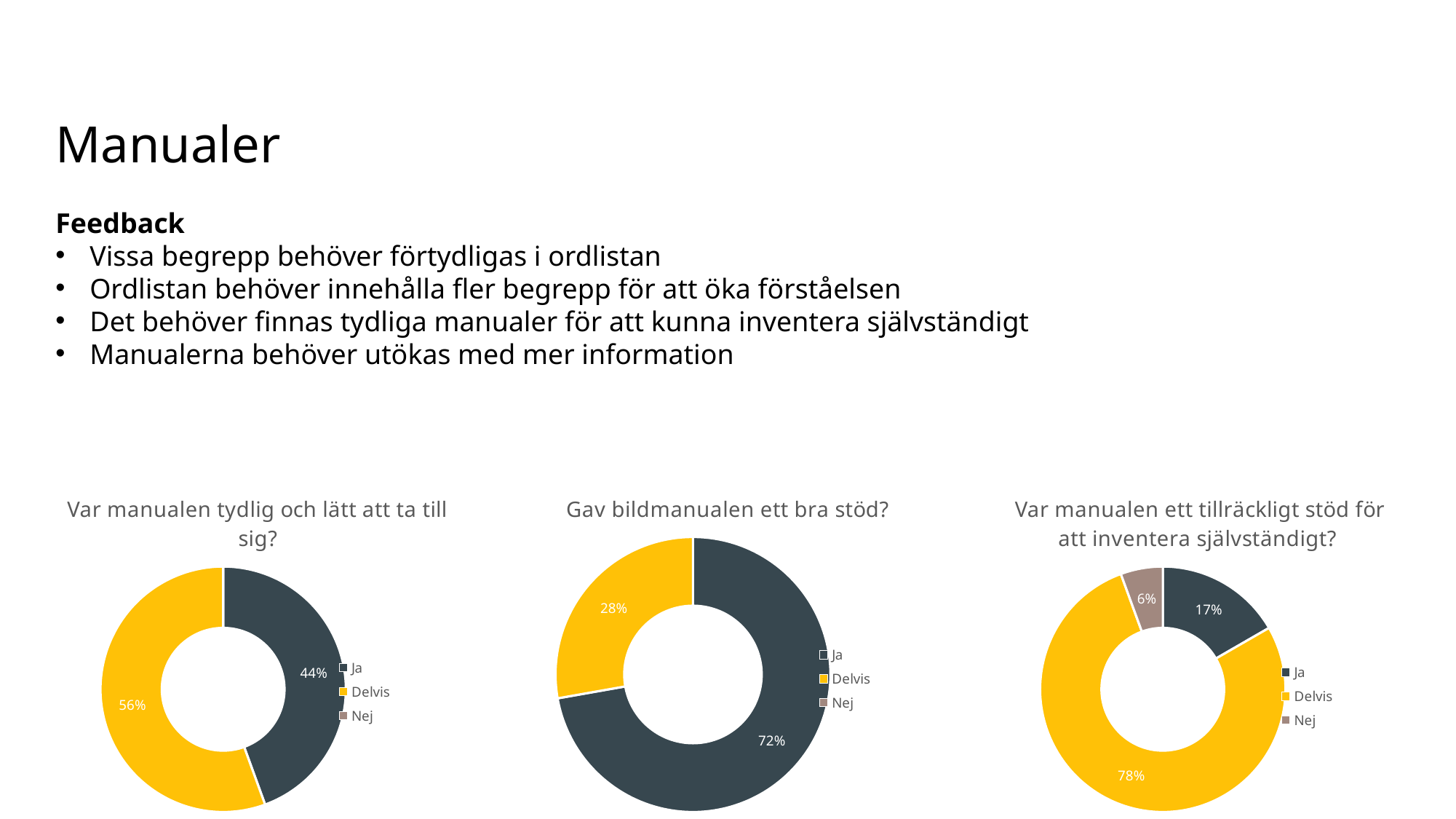
In the chart 'Var manualen ett tillräckligt stöd för att inventera självständigt?', what share answered Delvis? 78% How many entries does the legend of the chart 'Var manualen ett tillräckligt stöd för att inventera självständigt?' list? 3 What kind of chart is 'Gav bildmanualen ett bra stöd?' Donut chart In the chart 'Var manualen ett tillräckligt stöd för att inventera självständigt?', which answer has the largest share? Delvis In the chart 'Var manualen tydlig och lätt att ta till sig?', what share answered Delvis? 56% In the chart 'Gav bildmanualen ett bra stöd?', what share answered Delvis? 28% In the chart 'Gav bildmanualen ett bra stöd?', what is the difference between the Ja and Delvis shares? 44 percentage points In the chart 'Var manualen ett tillräckligt stöd för att inventera självständigt?', what share answered Nej? 6% In the chart 'Var manualen tydlig och lätt att ta till sig?', which is larger, Ja or Delvis? Delvis In the chart 'Gav bildmanualen ett bra stöd?', what share answered Ja? 72% In the chart 'Var manualen ett tillräckligt stöd för att inventera självständigt?', which answer has the smallest share? Nej In the chart 'Var manualen tydlig och lätt att ta till sig?', what share answered Ja? 44%